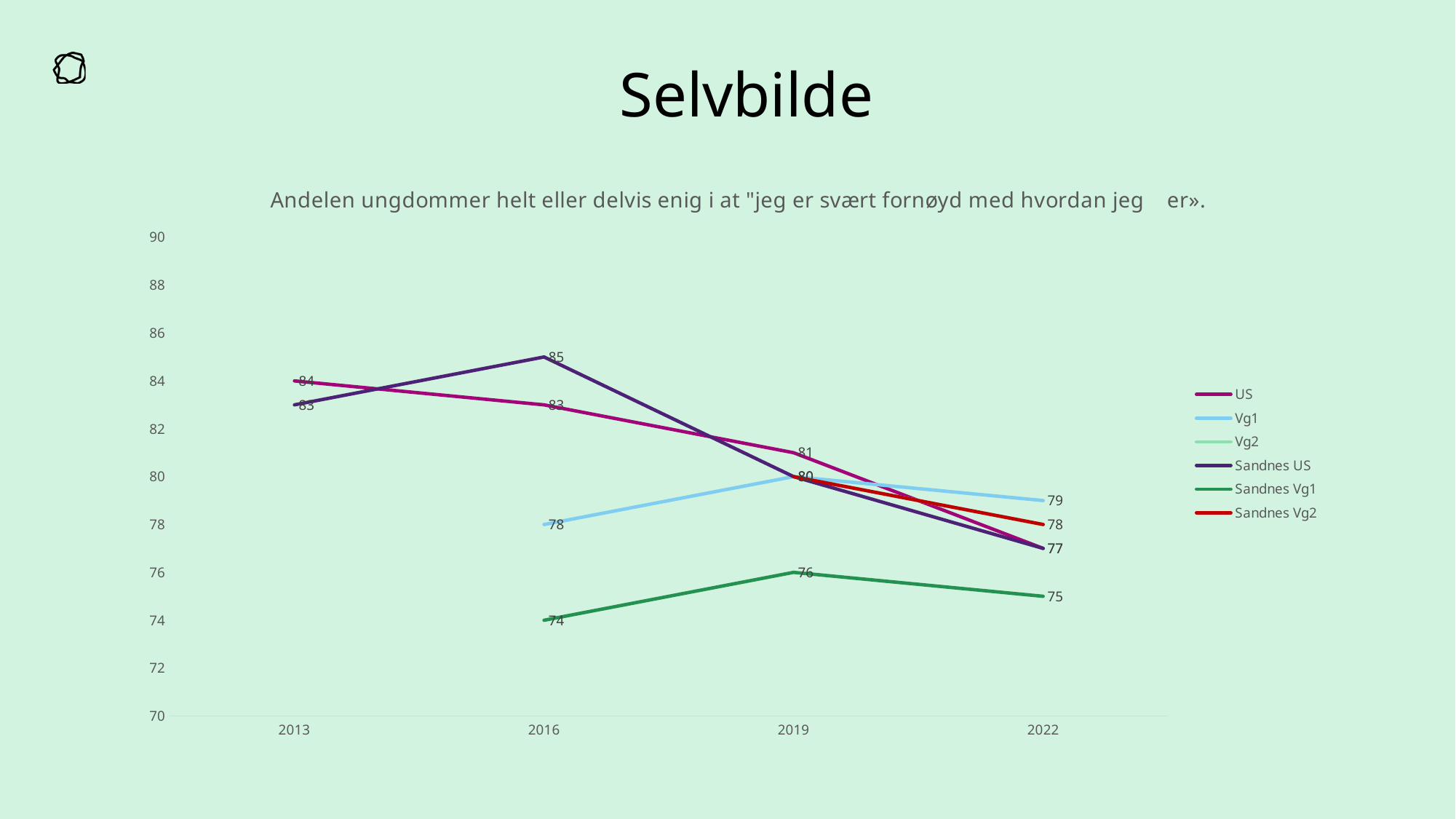
How many years are shown on the x axis? 4 What is the difference between the US value in 2013 and in 2022? 7 Does the US series rise or fall from 2013 to 2022? fall In 2022, which is larger: Vg1 or Sandnes Vg2? Vg1 How many series does the legend list? 6 What is the value for US in 2013? 84 In which year does Sandnes US reach its highest value? 2016 What is the value for Sandnes US in 2016? 85 What kind of chart is shown on the slide? line chart What is the value for Vg1 in 2022? 79 What is the value for Sandnes Vg1 in 2016? 74 In which year does Sandnes Vg1 have its lowest value? 2016